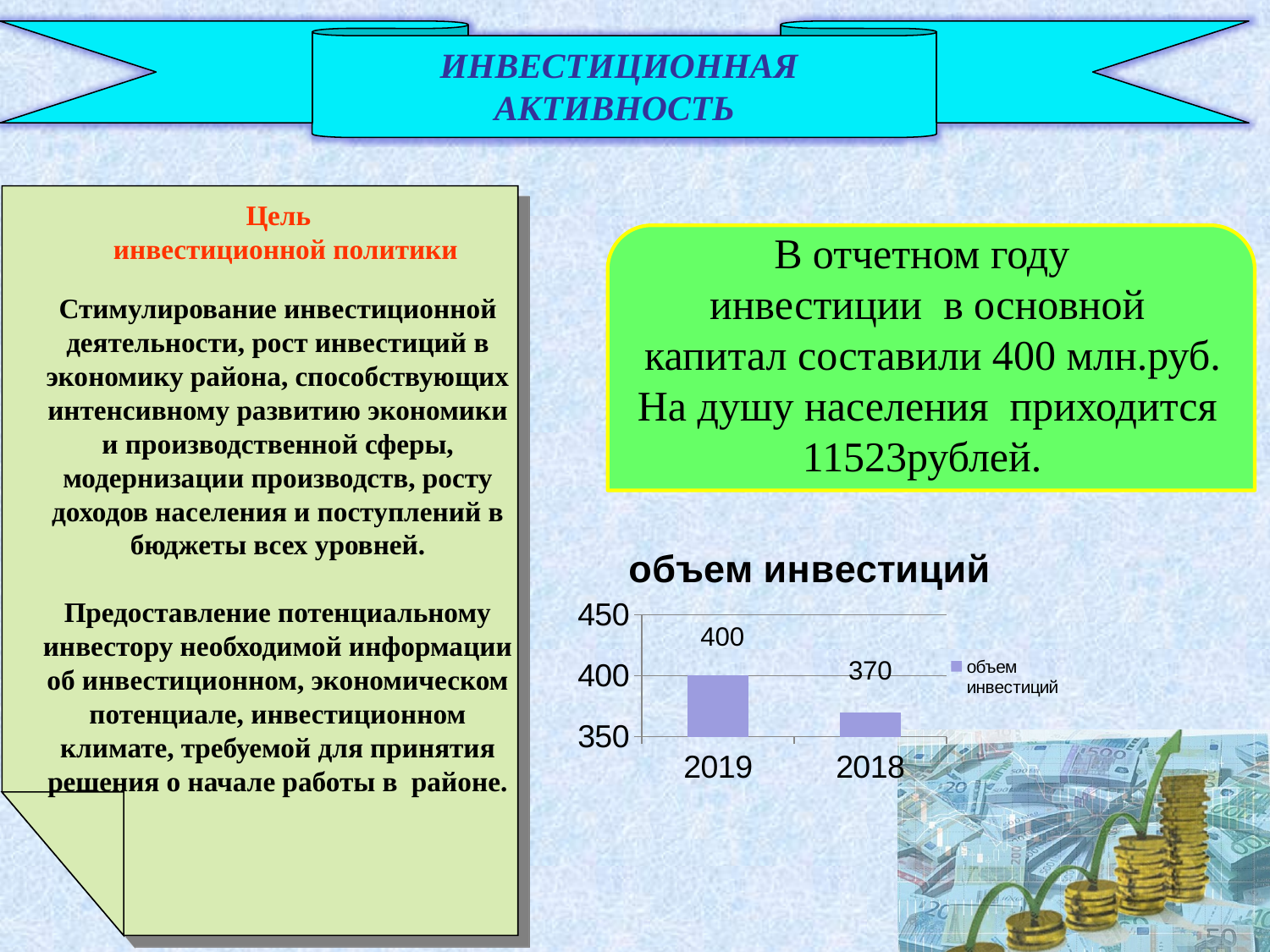
What is the value for 2019 in the chart 'объем инвестиций'? 400 Which is larger in the chart 'объем инвестиций': the value for 2019 or for 2018? 2019 How many series does the legend of the chart 'объем инвестиций' list? 1 What kind of chart is 'объем инвестиций'? bar chart Which year has the highest value in the chart 'объем инвестиций'? 2019 How many categories are shown in the chart 'объем инвестиций'? 2 Is the value for 2018 in the chart 'объем инвестиций' greater or less than 400? less Which year has the lowest value in the chart 'объем инвестиций'? 2018 What is the difference between the values for 2019 and 2018 in the chart 'объем инвестиций'? 30 What is the value for 2018 in the chart 'объем инвестиций'? 370 What is the highest value shown on the vertical axis of the chart 'объем инвестиций'? 450 What is the title of the chart on the slide? объем инвестиций